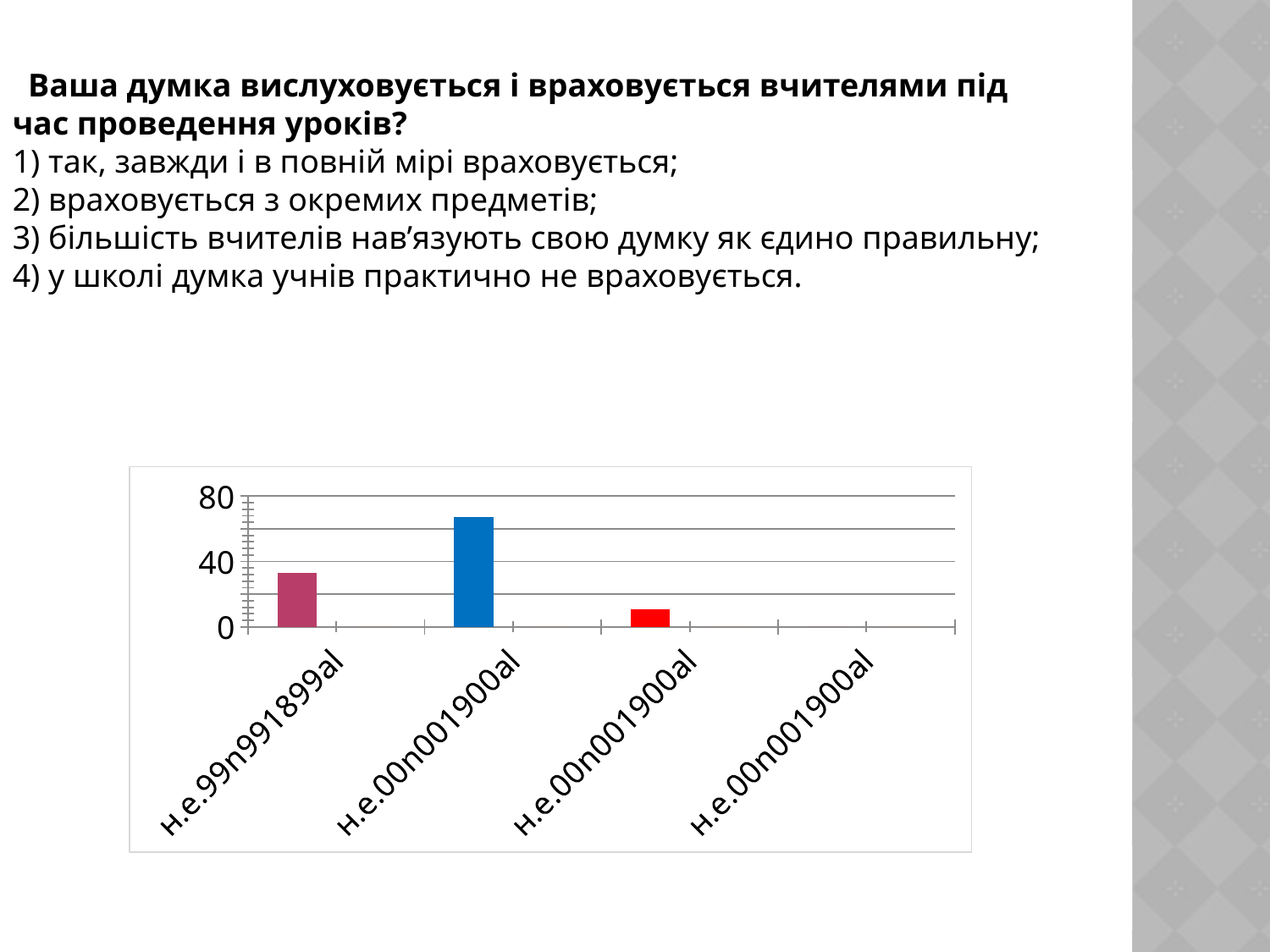
How many bars are drawn in the chart? 3 What colour is the tallest bar in the chart? blue How many category labels are shown along the x axis of the chart? 4 Is the value of the second (blue) bar greater or less than 40? greater Which bar is the tallest in the chart? the second (blue) bar What is the highest value shown on the vertical axis of the chart? 80 Which is larger, the first (magenta) bar or the second (blue) bar? the second (blue) bar Is the value of the third (red) bar greater or less than 40? less Is the value of the second (blue) bar greater or less than 80? less What kind of chart is shown on the slide? bar chart Which of the drawn bars is the shortest in the chart? the third (red) bar